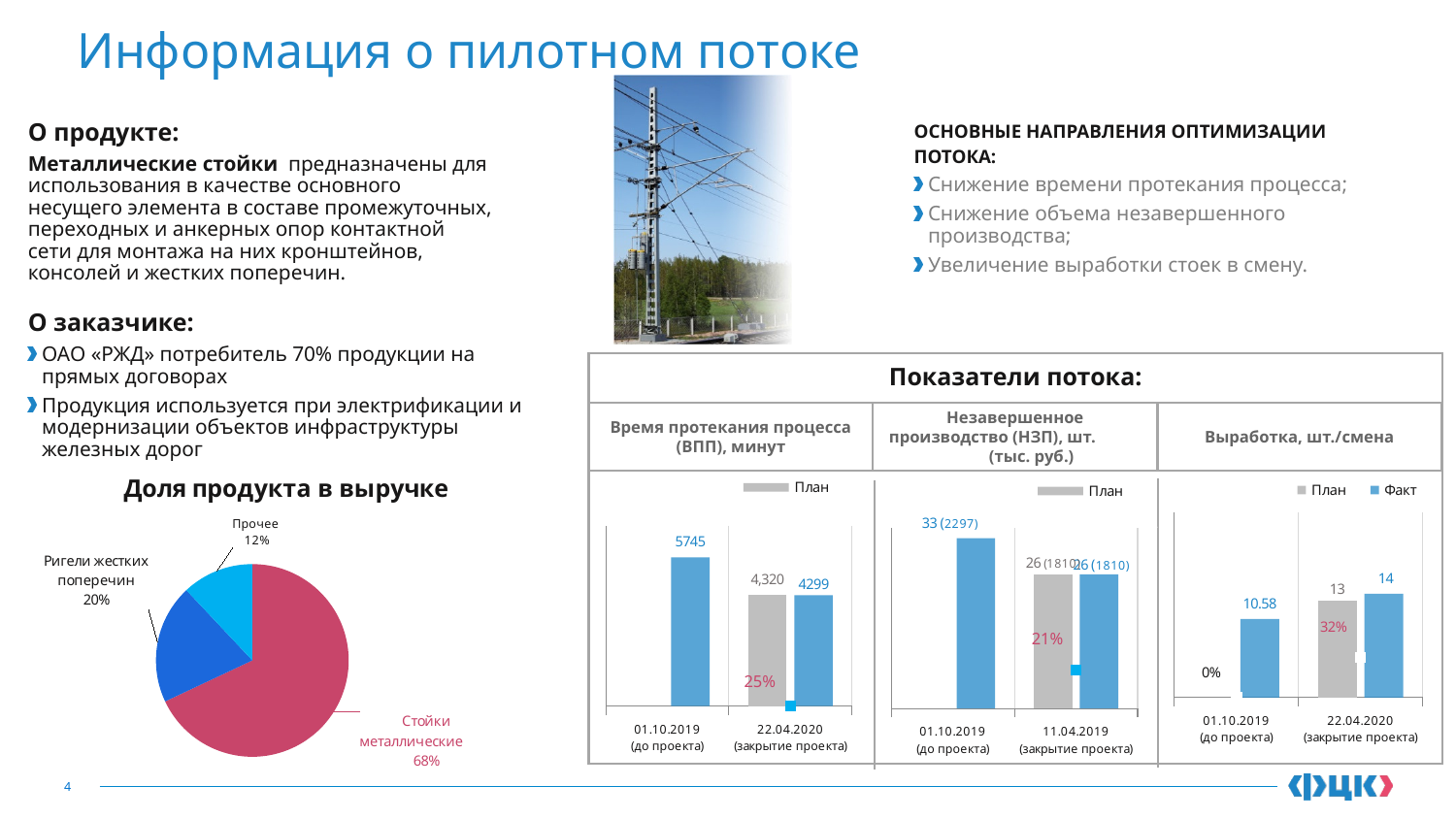
In the 'Доля продукта в выручке' chart, what is the share for 'Ригели жестких поперечин'? 20% How many slices does the 'Доля продукта в выручке' pie chart have? 3 In the 'Время протекания процесса (ВПП), минут' chart, what is the План value for 22.04.2020? 4,320 In the 'Время протекания процесса (ВПП), минут' chart, what is the actual (Факт) value for 22.04.2020 (закрытие проекта)? 4299 In the 'Время протекания процесса (ВПП), минут' chart, what is the value for 01.10.2019 (до проекта)? 5745 What kind of chart is 'Доля продукта в выручке'? pie chart In the 'Незавершенное производство (НЗП)' chart, what is the value for 01.10.2019 (до проекта)? 33 (2297) In the 'Выработка, шт./смена' chart, what is the difference between the Факт value (14) and the План value (13) for 22.04.2020? 1 In the 'Доля продукта в выручке' chart, which category has the smallest slice? Прочее In the 'Выработка, шт./смена' chart, which is larger for 22.04.2020: План or Факт? Факт In the 'Выработка, шт./смена' chart, what is the value for 01.10.2019 (до проекта)? 10.58 In the 'Доля продукта в выручке' chart, what share of revenue do 'Стойки металлические' account for? 68%